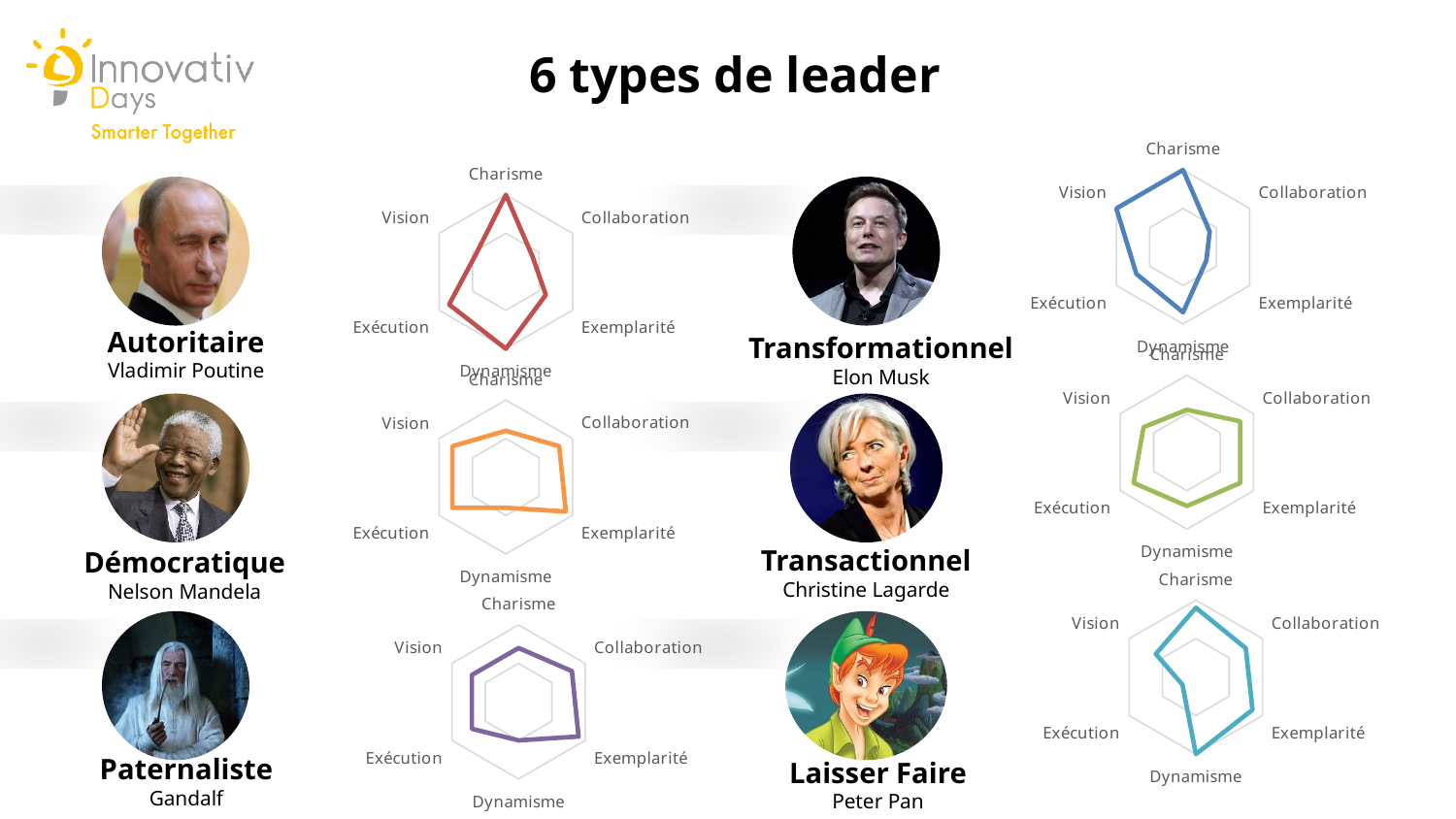
How many axes (categories) does the Autoritaire radar chart have? 6 In the Transformationnel (Elon Musk) radar chart, which is larger: Charisme or Exemplarité? Charisme In the Transactionnel (Christine Lagarde) radar chart, which is larger: Collaboration or Charisme? Collaboration In the Autoritaire (Vladimir Poutine) radar chart, which is larger: Charisme or Collaboration? Charisme What colour is the line in the Démocratique (Nelson Mandela) radar chart? orange Which axis label appears at the top of each radar chart? Charisme What colour is the line in the Paternaliste (Gandalf) radar chart? purple What kind of chart is used for each of the six leader types on the slide? radar chart How many radar charts are shown on the slide? 6